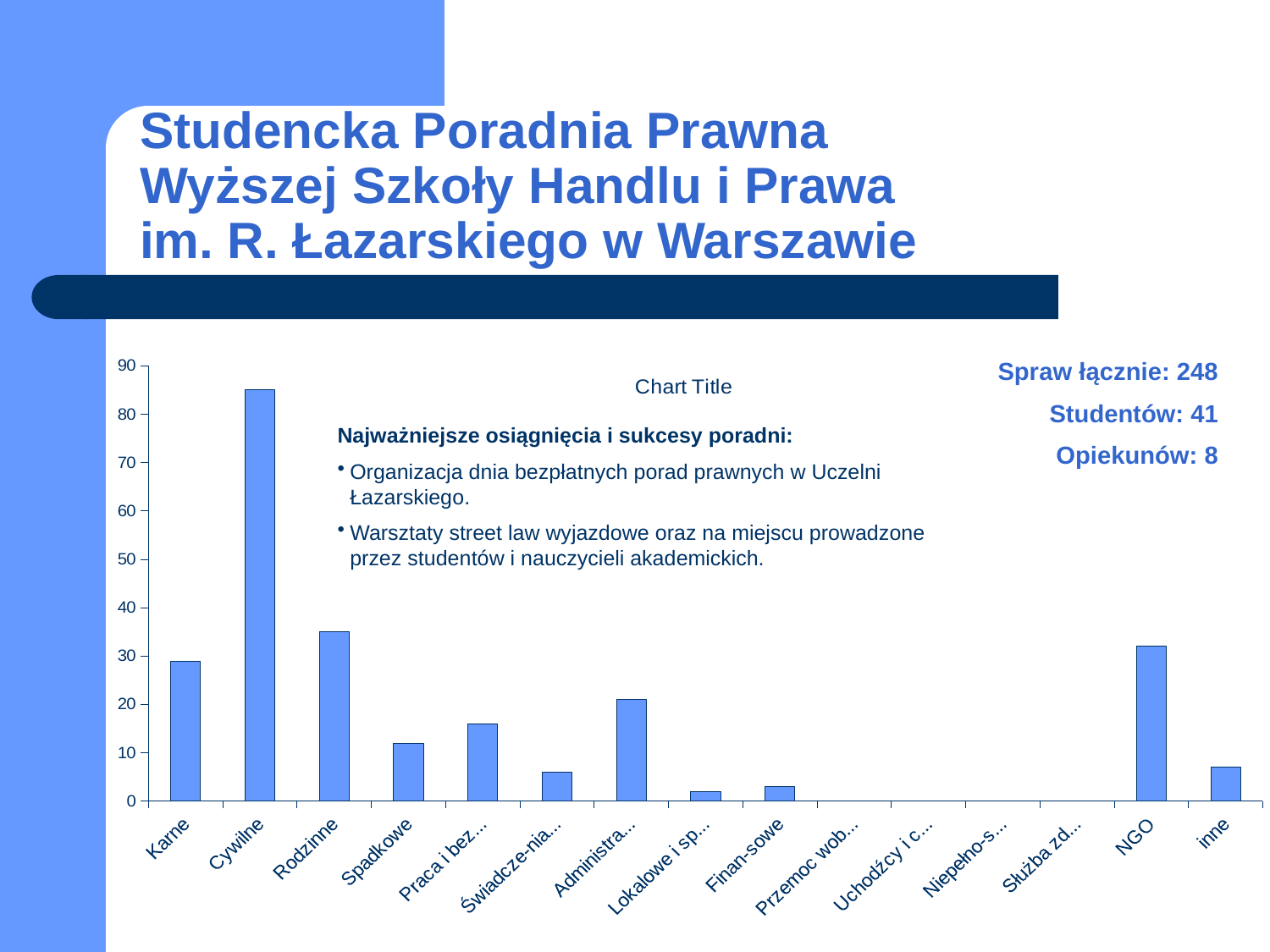
Is the value for NGO greater or less than 30? greater Which is larger, the value for Karne or the value for Spadkowe? Karne Is the value for Cywilne greater or less than 80? greater Which is larger, the value for Cywilne or the value for Rodzinne? Cywilne Is the value for Spadkowe greater or less than 20? less Which category has the tallest bar in the chart? Cywilne What is the title shown on the chart? Chart Title How many categories are shown on the x axis of the chart? 15 What kind of chart is shown on the slide? bar chart